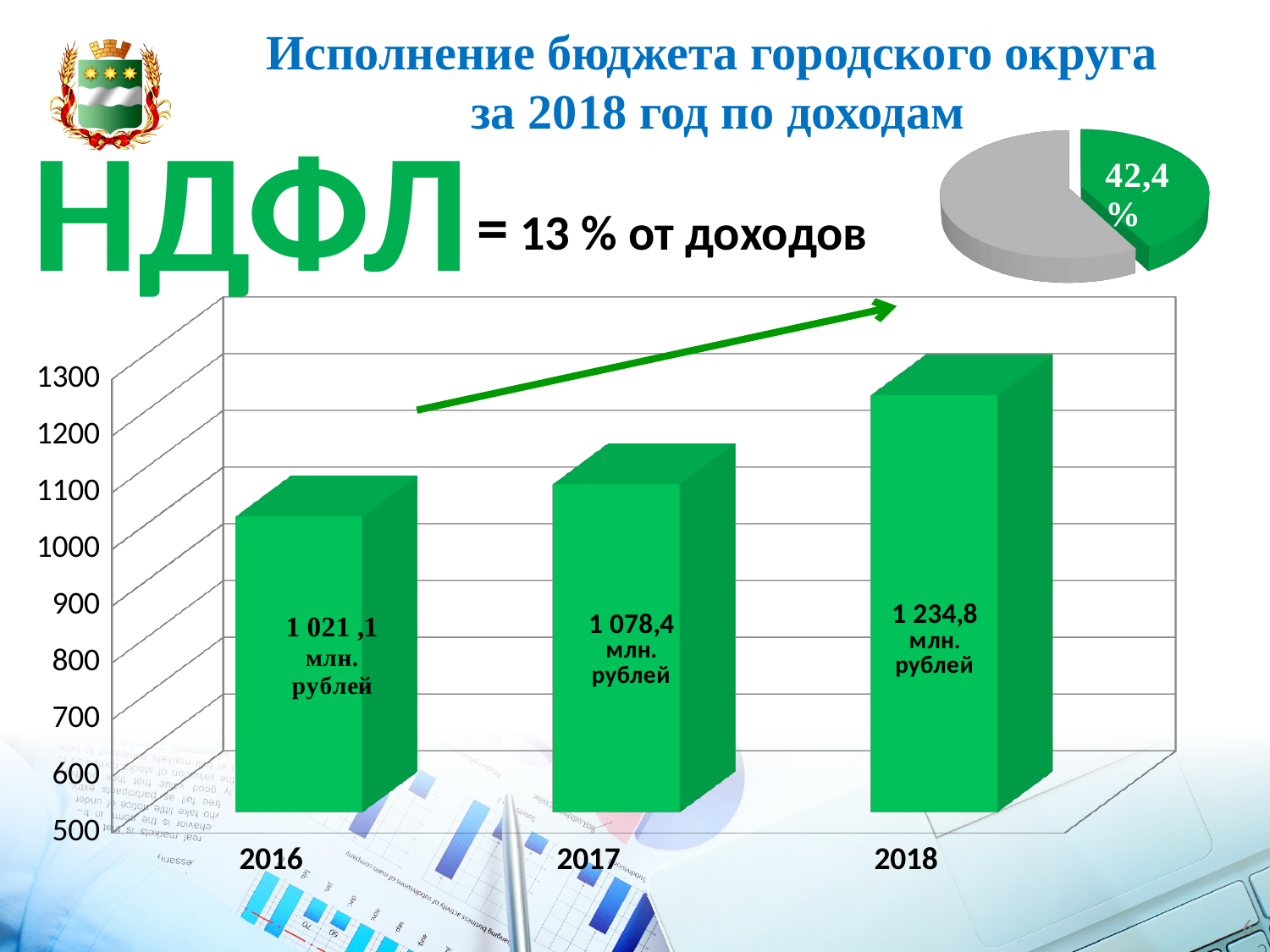
In the bar chart, what is the value for 2018? 1 234,8 млн. рублей In the bar chart, which year has the highest value? 2018 In the bar chart, which is larger, the value for 2017 or the value for 2018? 2018 In the bar chart, what is the value for 2017? 1 078,4 млн. рублей In the bar chart, how many years are shown? 3 In the bar chart, what is the value for 2016? 1 021,1 млн. рублей In the bar chart, what is the difference between the 2017 and 2016 values? 57,3 млн. рублей In the bar chart, which year has the lowest value? 2016 What kind of chart is the large chart at the bottom of the slide? bar chart In the bar chart, do the values rise or fall from 2016 to 2018? rise In the bar chart, what is the difference between the 2018 and 2016 values? 213,7 млн. рублей In the pie chart in the top right corner, what share does the green slice represent? 42,4 %